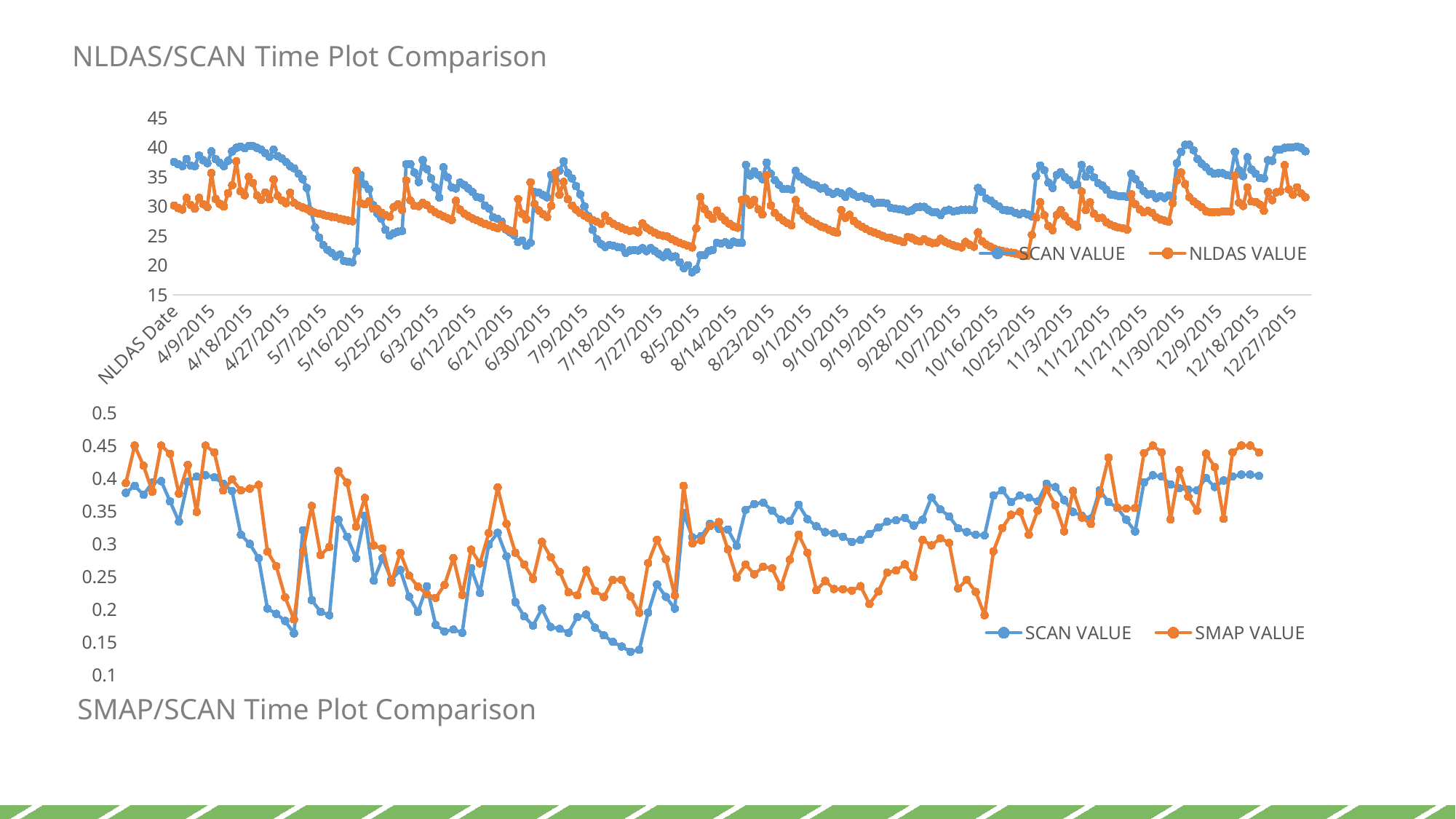
In the NLDAS/SCAN Time Plot Comparison chart, which series has the larger value at 8/5/2015, SCAN VALUE or NLDAS VALUE? NLDAS VALUE How many series does the legend of the SMAP/SCAN Time Plot Comparison chart list? 2 What kind of chart is the NLDAS/SCAN Time Plot Comparison chart at the top of the slide? line chart What kind of chart is the SMAP/SCAN Time Plot Comparison chart at the bottom of the slide? line chart In the NLDAS/SCAN Time Plot Comparison chart, which series is drawn in orange? NLDAS VALUE In the NLDAS/SCAN Time Plot Comparison chart, is the SCAN VALUE at 4/18/2015 greater or less than 35? greater In the SMAP/SCAN Time Plot Comparison chart, what are the two legend entries? SCAN VALUE and SMAP VALUE In the NLDAS/SCAN Time Plot Comparison chart, is the SCAN VALUE at 8/5/2015 greater or less than 25? less In the NLDAS/SCAN Time Plot Comparison chart, is the NLDAS VALUE at 4/18/2015 greater or less than 30? greater How many series does the legend of the NLDAS/SCAN Time Plot Comparison chart list? 2